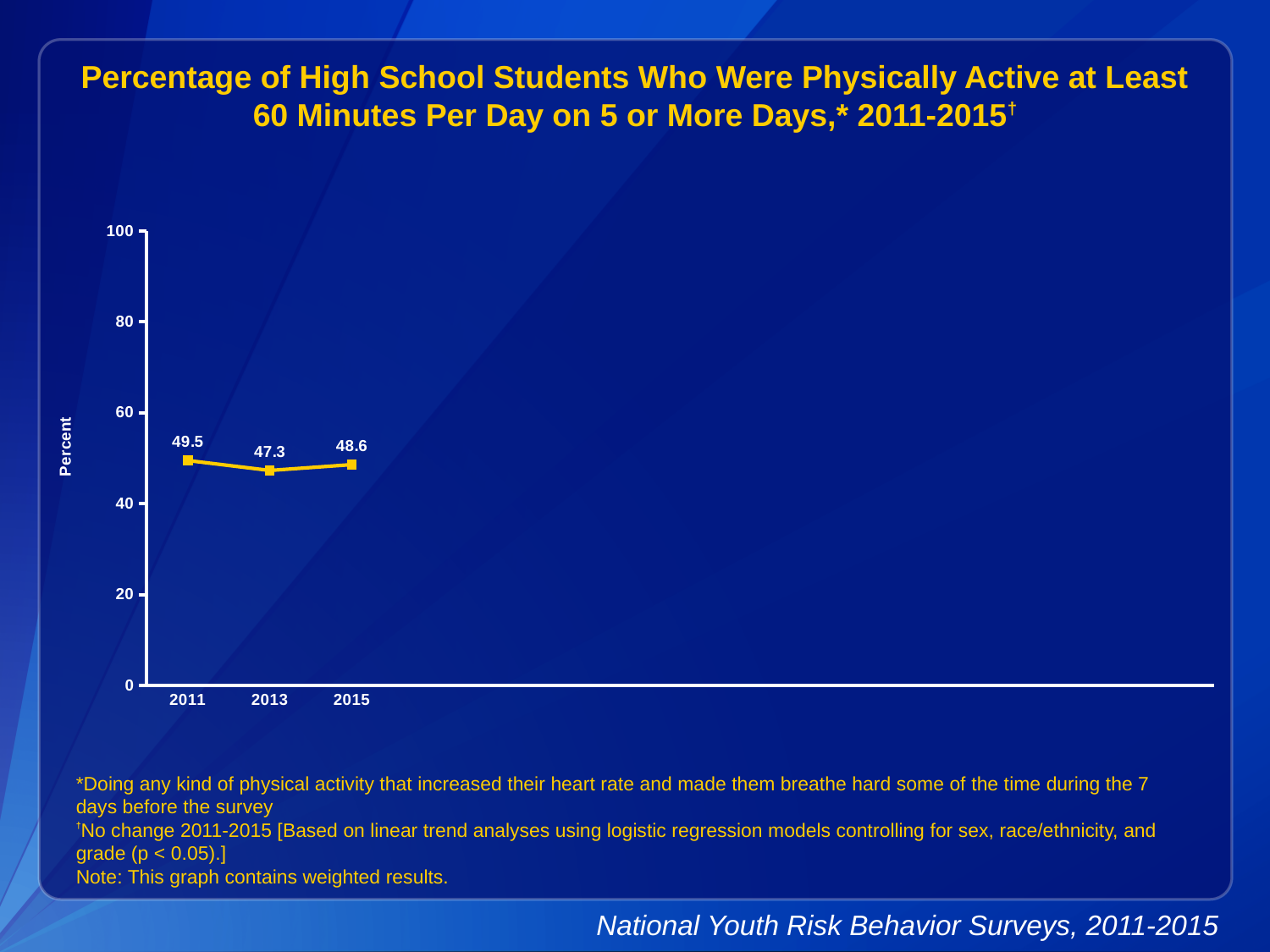
What is the difference between the 2011 and 2013 values? 2.2 What was the percentage of high school students who were physically active at least 60 minutes per day on 5 or more days in 2011? 49.5 What is the difference between the 2015 and 2013 values? 1.3 What value is shown for 2013? 47.3 Which year has the lowest percentage? 2013 What kind of chart is shown on the slide? line chart Which is larger, the value for 2011 or the value for 2015? 2011 Is the value for 2013 greater or less than 60? less What is the label on the y axis? Percent Which year has the highest percentage? 2011 How many years are plotted on the chart? 3 What value is shown for 2015? 48.6